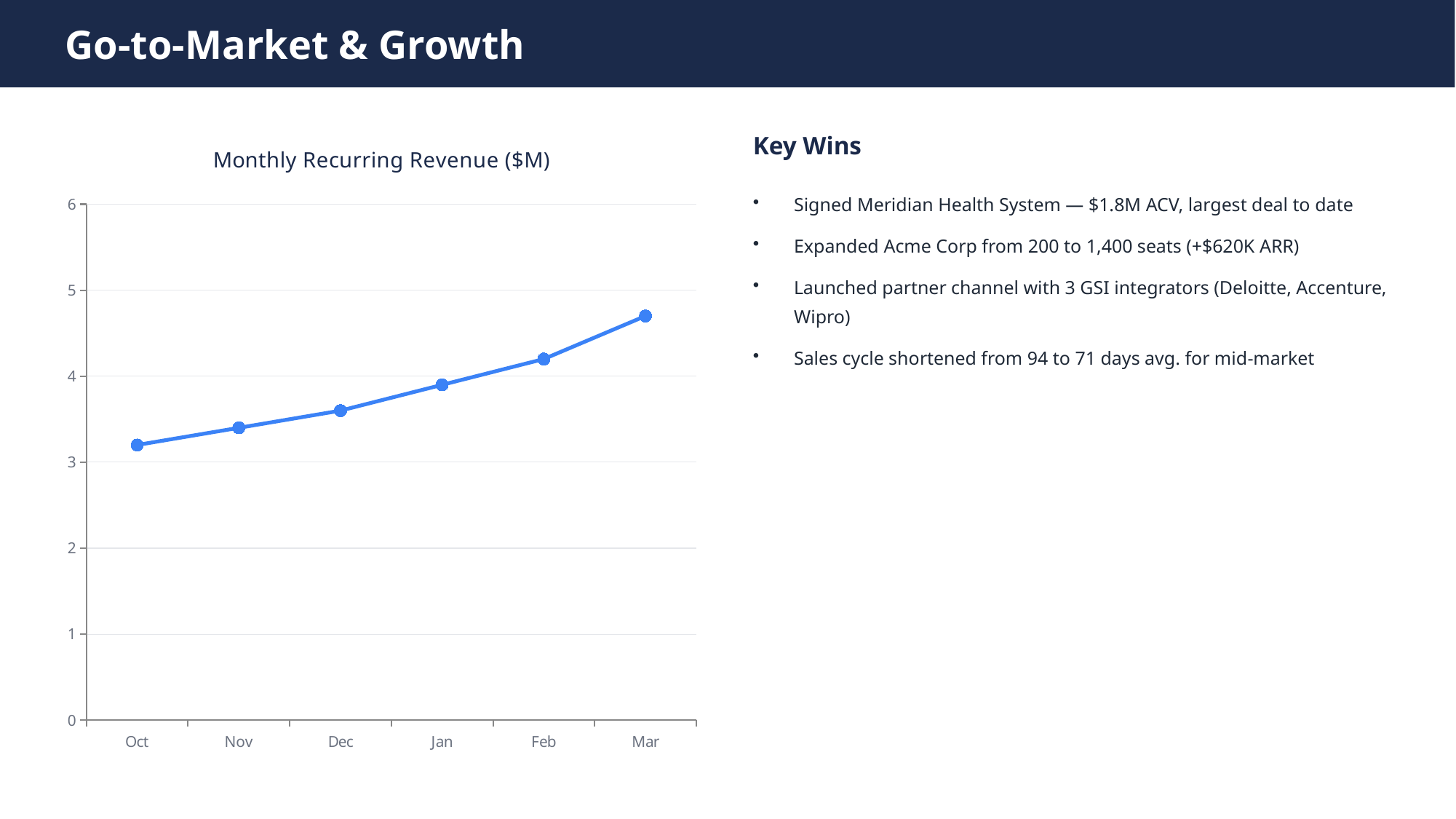
What kind of chart is shown on the slide? line chart How many months are plotted on the chart? 6 Is the value for Oct greater or less than 4? less Is the value for Mar greater or less than 4? greater Which month has the highest monthly recurring revenue? Mar Which month has the lowest monthly recurring revenue? Oct Is the value for Mar greater or less than 5? less Do the values rise or fall from Oct to Mar? rise Which is larger, the value for Mar or the value for Oct? Mar What is the title of the chart? Monthly Recurring Revenue ($M) Which is larger, the value for Feb or the value for Nov? Feb